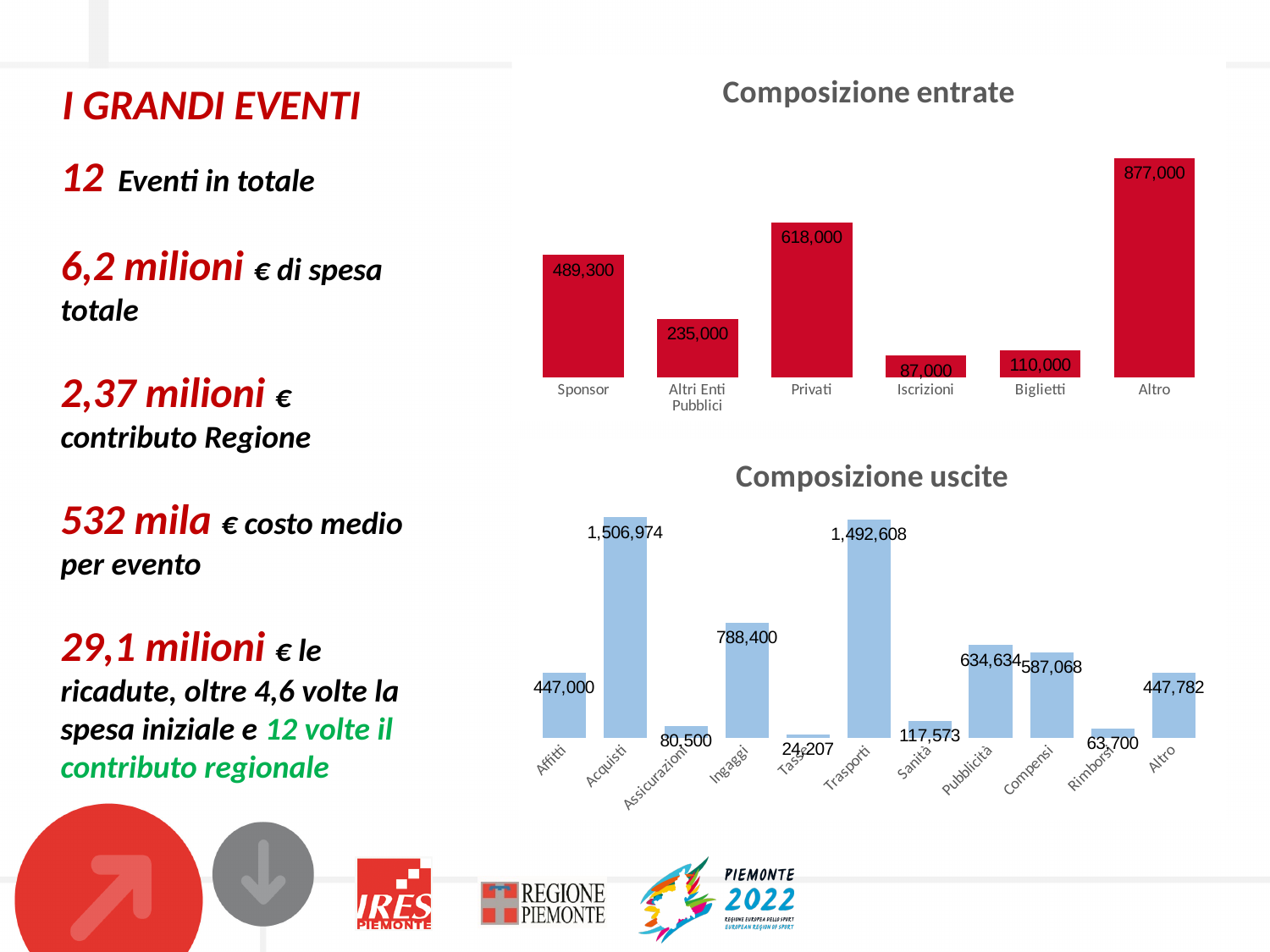
In the 'Composizione uscite' chart, how many categories are shown? 11 In the 'Composizione entrate' chart, what is the difference between Privati and Altri Enti Pubblici? 383,000 In the 'Composizione entrate' chart, which category has the lowest value? Iscrizioni In the 'Composizione uscite' chart, which category has the lowest value? Tasse In the 'Composizione uscite' chart, what is the difference between Pubblicità and Compensi? 47,566 In the 'Composizione uscite' chart, which category has the highest value? Acquisti In the 'Composizione entrate' chart, what is the value for Sponsor? 489,300 What type of chart is 'Composizione uscite'? Bar chart In the 'Composizione entrate' chart, which is larger, Biglietti or Iscrizioni? Biglietti In the 'Composizione entrate' chart, how many categories are shown? 6 In the 'Composizione entrate' chart, which category has the highest value? Altro In the 'Composizione uscite' chart, what is the value for Trasporti? 1,492,608